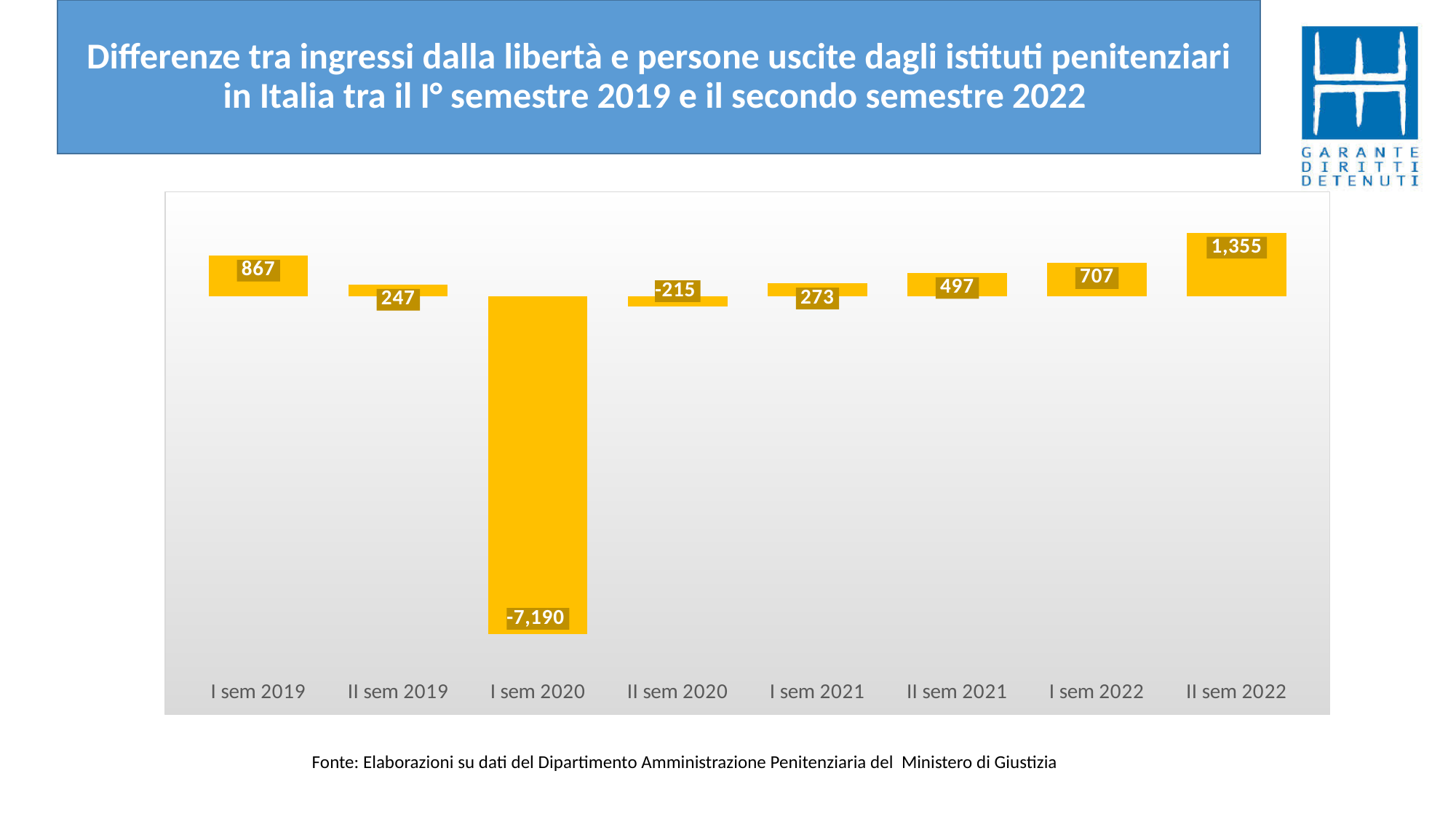
What is the difference between the values for II sem 2022 and I sem 2022? 648 Which semester has the lowest value? I sem 2020 What is the value for II sem 2020? -215 What is the source cited below the chart? Elaborazioni su dati del Dipartimento Amministrazione Penitenziaria del Ministero di Giustizia What is the value for II sem 2022? 1,355 What is the value for I sem 2019? 867 Do the values rise or fall from II sem 2020 to II sem 2022? Rise What is the value for I sem 2020? -7,190 Which semester has the highest value? II sem 2022 Which is larger, the value for I sem 2021 or the value for II sem 2021? II sem 2021 What kind of chart is shown on the slide? Bar chart How many semesters are shown on the x axis? 8